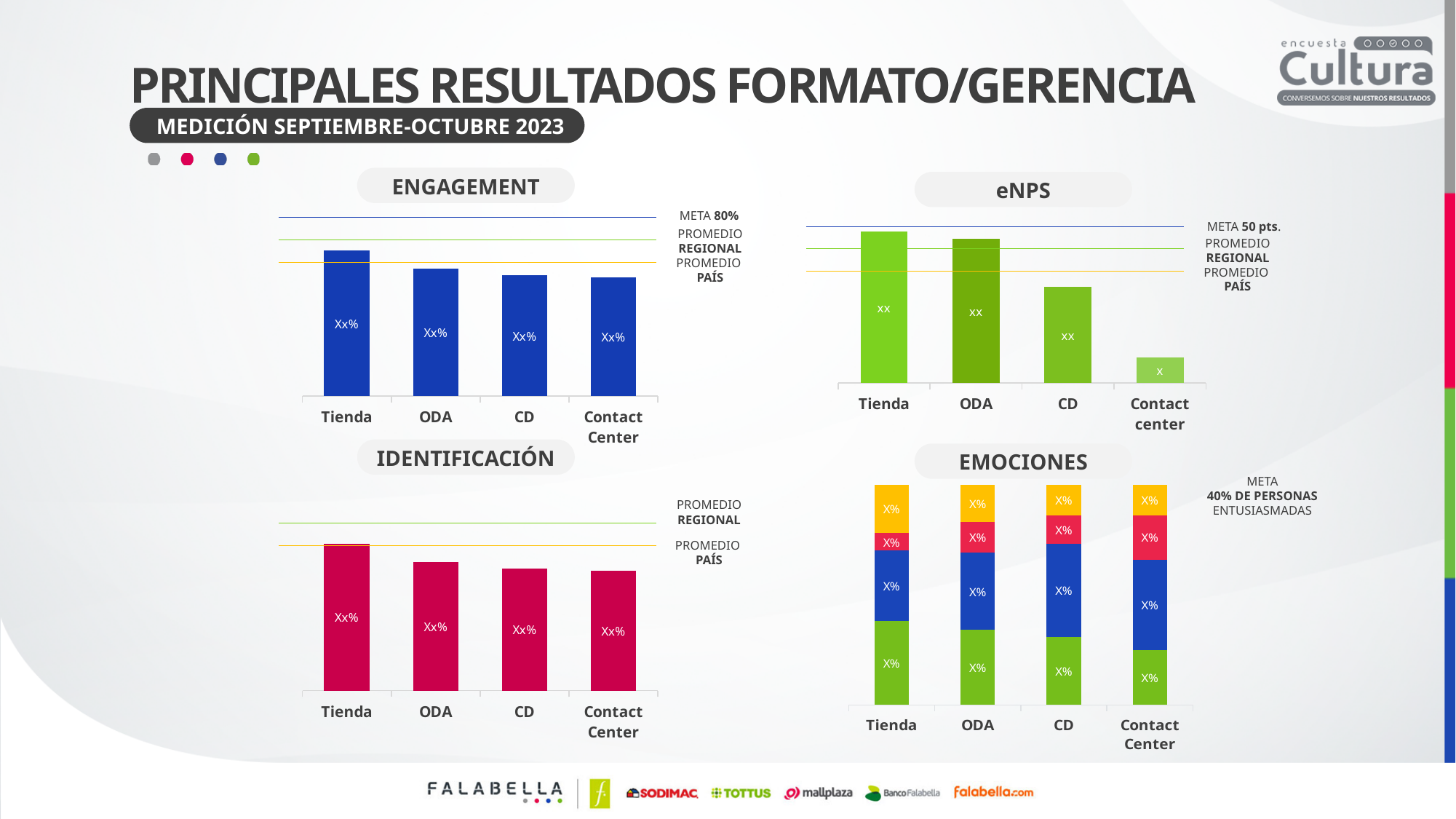
What is the META value stated next to the eNPS chart? 50 pts. What is the META value stated next to the ENGAGEMENT chart? 80% How many categories are shown on the ENGAGEMENT chart? 4 On the eNPS chart, which category has the lowest bar? Contact center How many categories are shown on the IDENTIFICACIÓN chart? 4 On the eNPS chart, which bar is taller, ODA or CD? ODA On the eNPS chart, which category has the highest bar? Tienda On the IDENTIFICACIÓN chart, which category has the highest bar? Tienda What kind of chart is the ENGAGEMENT chart? Bar chart On the ENGAGEMENT chart, do the bars rise or fall from Tienda to Contact Center? Fall On the ENGAGEMENT chart, which category has the highest bar? Tienda What kind of chart is the EMOCIONES chart? Stacked bar chart